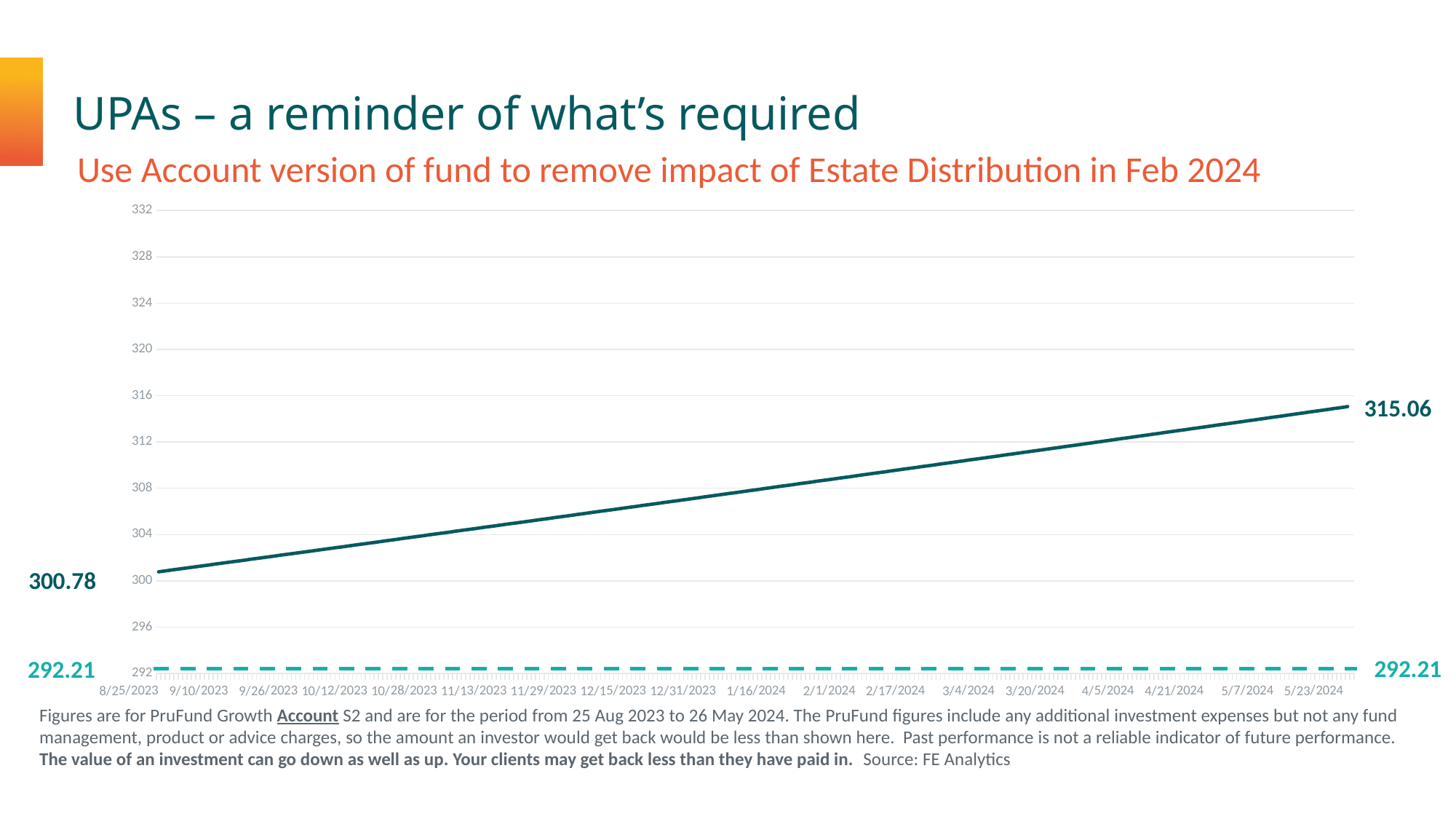
Does the solid line rise or fall from left to right across the period? rise Does the dashed line rise, fall or stay flat across the period? stay flat By how much does the solid line rise from its start value to its end value? 14.28 What value does the dashed line show at the end of the period? 292.21 What is the value of the solid line at the end of the period? 315.06 Which line has the higher value at the end of the period, the solid line or the dashed line? the solid line What kind of chart is shown on the slide? line chart What is the value of the solid line at the start of the period (8/25/2023)? 300.78 Is the value of the solid line on 1/16/2024 greater or less than 304? greater What value does the dashed line show at the start of the period? 292.21 Is the value of the solid line on 1/16/2024 greater or less than 312? less How many lines are plotted on the chart? 2